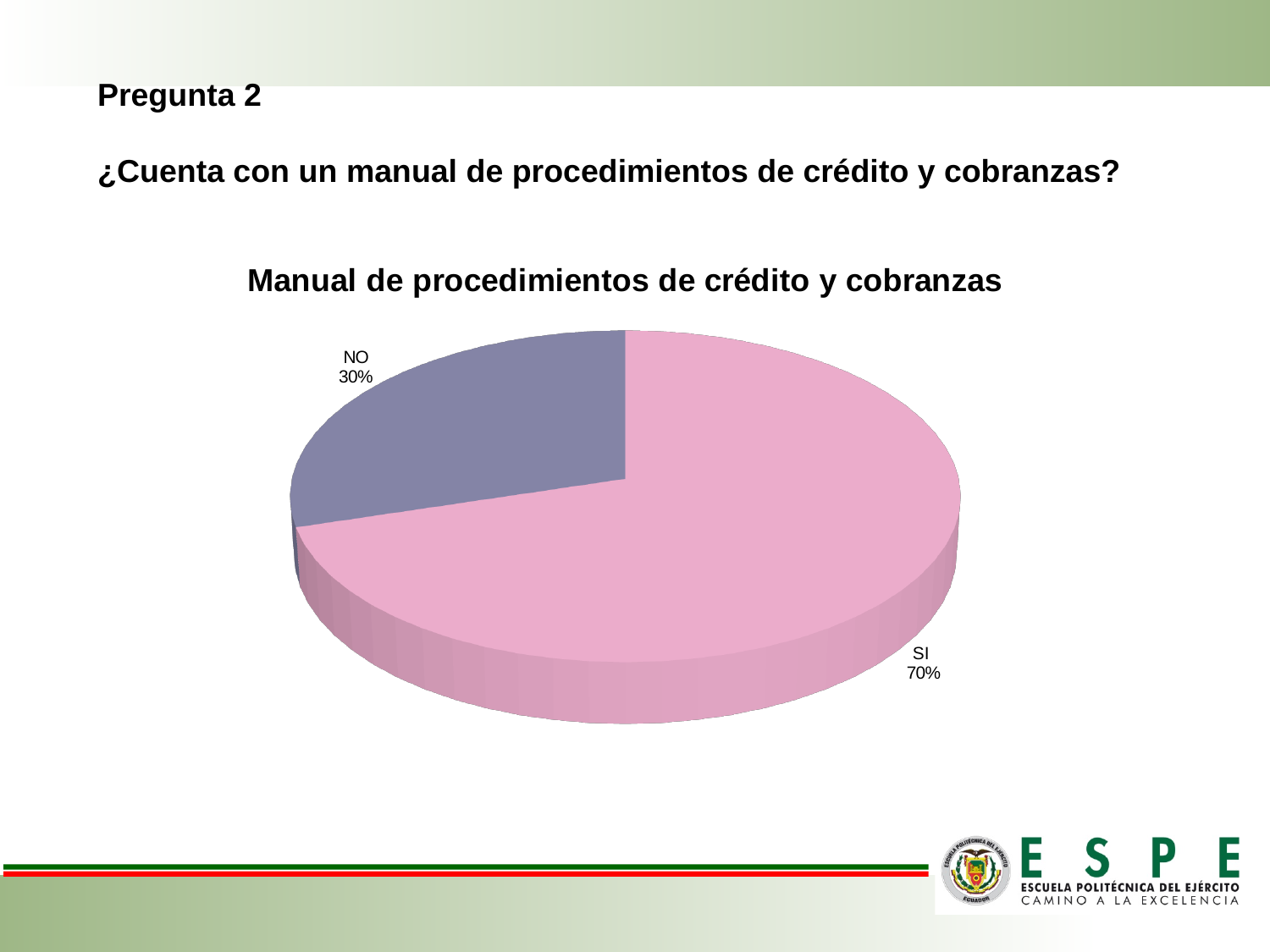
What is the difference in percentage points between the SI and NO slices? 40 Which slice of the pie is the smallest? NO What share of the pie does the NO slice represent? 30% What percentage of the pie is labelled SI? 70% What kind of chart is shown on the slide? pie chart How many slices does the pie chart have? 2 Which slice of the pie is the largest? SI What is the title of the chart? Manual de procedimientos de crédito y cobranzas What colour is the SI slice? pink Which is larger, the SI slice or the NO slice? SI What percentage of the pie is labelled NO? 30%